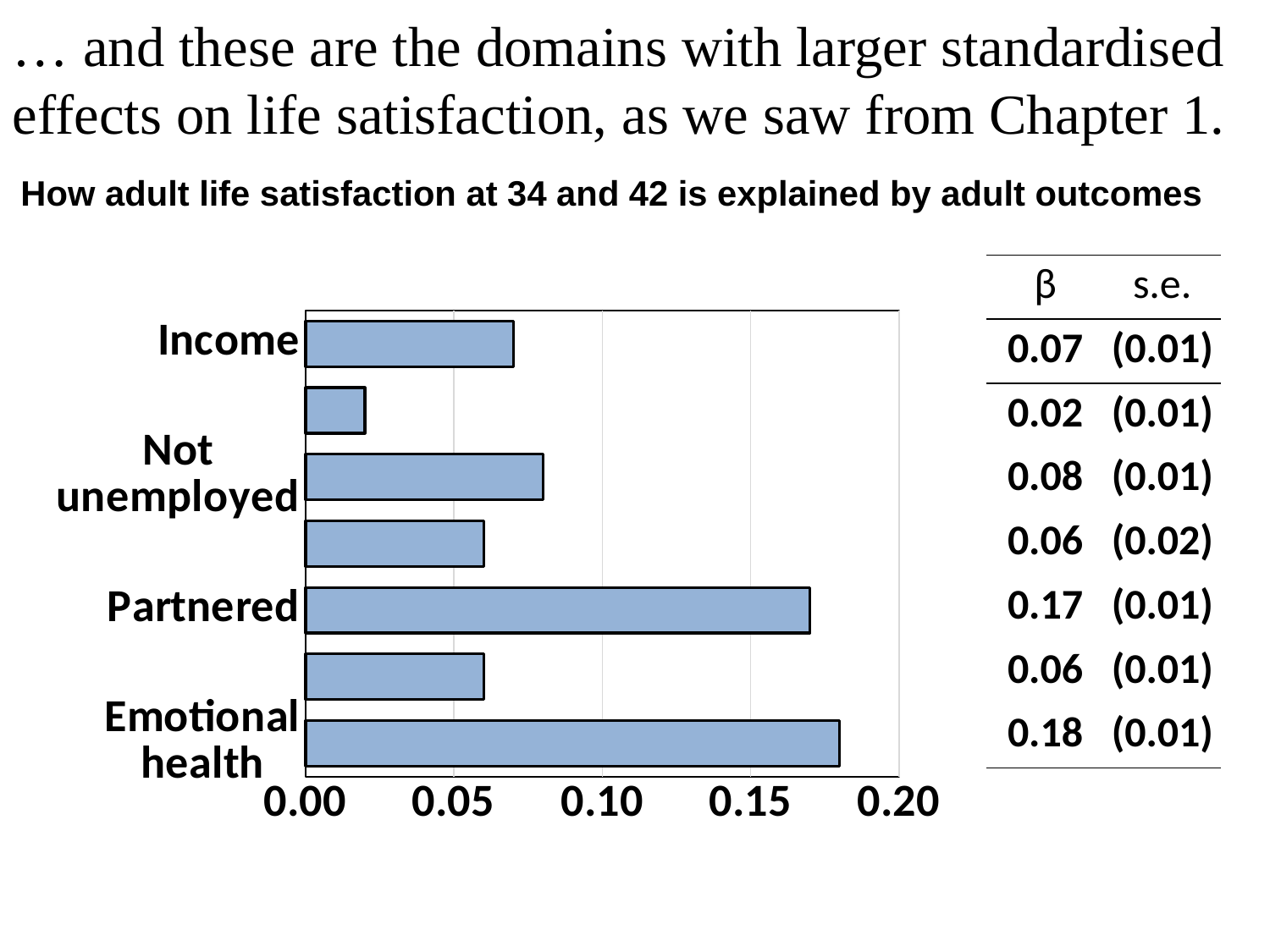
What is the title of the chart? How adult life satisfaction at 34 and 42 is explained by adult outcomes Is the β value for Partnered greater or less than 0.15? greater What kind of chart is shown on the slide? Bar chart How many bars are plotted in the chart? 7 Which has a larger β value, Partnered or Income? Partnered What is the difference between the β values for Emotional health and Income? 0.11 What is the β value for Not unemployed? 0.08 What is the β value for Partnered? 0.17 What is the difference between the β values for Partnered and Not unemployed? 0.09 What is the β value for Emotional health? 0.18 What is the β value for Income? 0.07 Which category has the highest β value? Emotional health